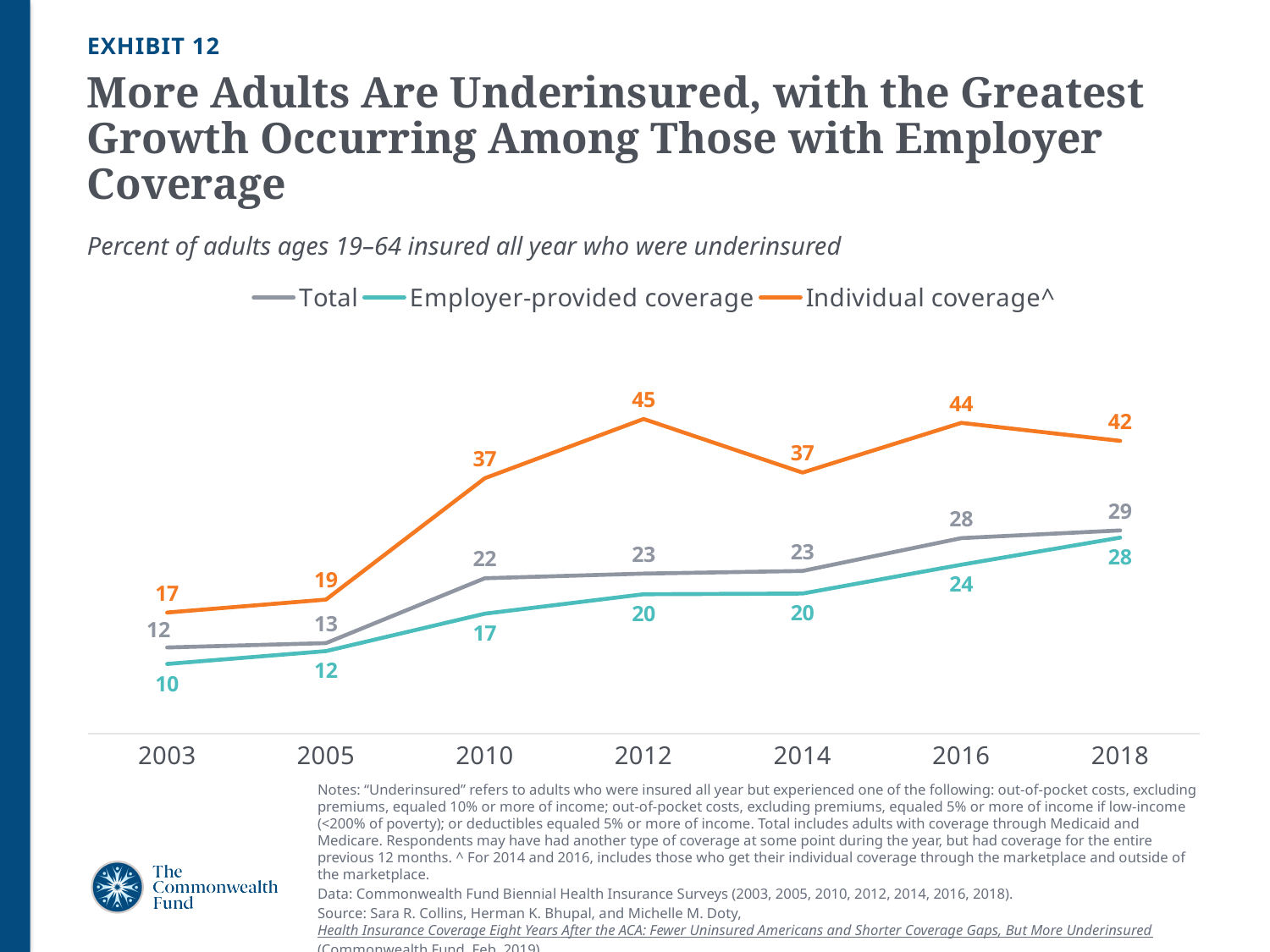
What is the difference between Individual coverage and Employer-provided coverage in 2018? 14 Which series is drawn in orange? Individual coverage^ Which is larger in 2014: the Total value or the Employer-provided coverage value? Total In which year is the Employer-provided coverage series at its lowest? 2003 In which year is the Individual coverage series at its highest? 2012 Does the Total series rise or fall from 2003 to 2018? Rise What is the Total value in 2016? 28 How many series does the legend list? 3 What is the value for Employer-provided coverage in 2003? 10 What is the value for Individual coverage in 2012? 45 How many years are shown on the x axis? 7 What kind of chart is shown on the slide? Line chart